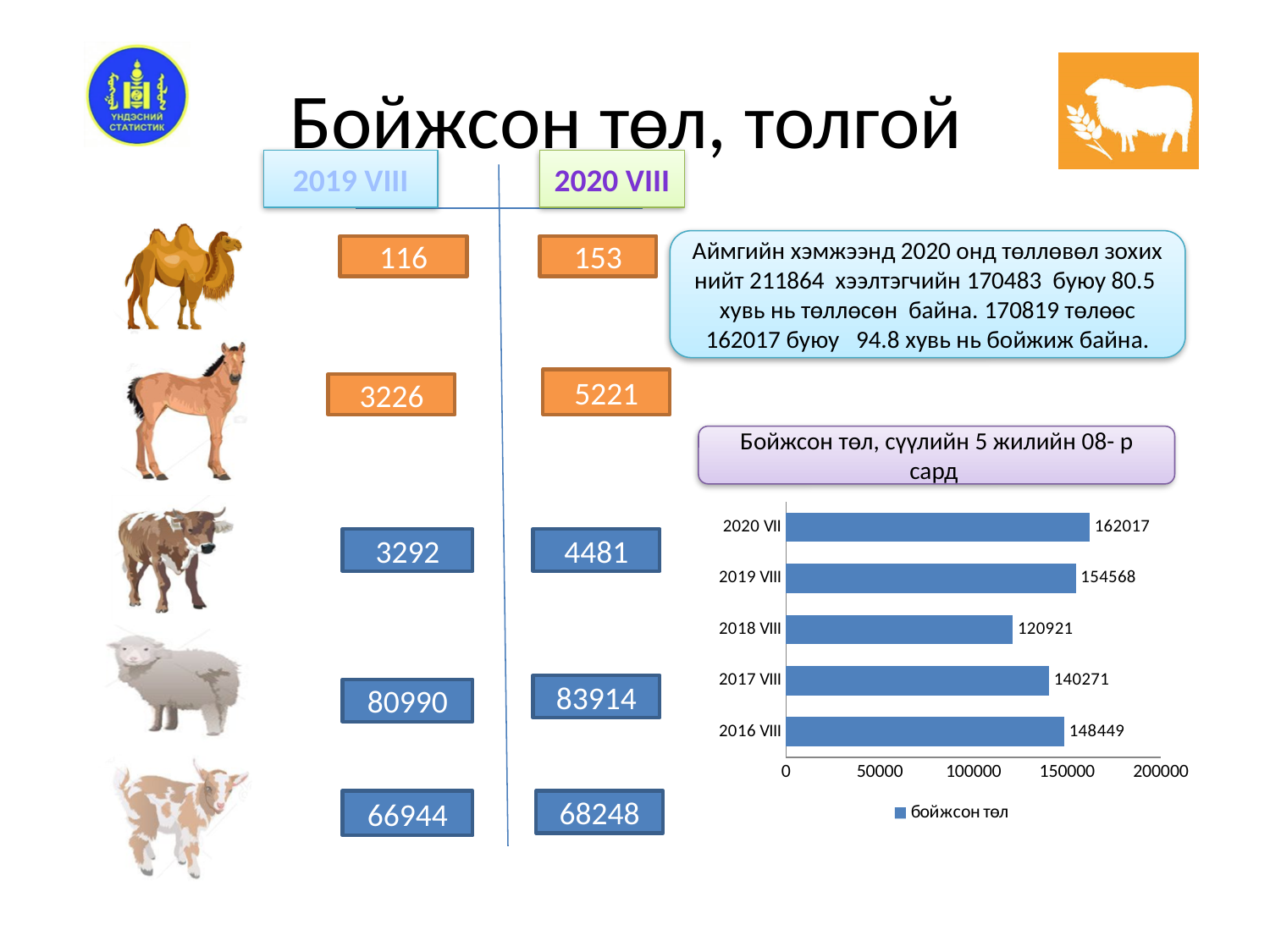
Is the value for 2018 VIII greater or less than 150000? less What is the difference between the values for 2020 VII and 2019 VIII? 7449 What is the value for 2020 VII in the chart? 162017 What is the value for 2018 VIII in the chart? 120921 How many series does the chart legend list? 1 What is the difference between the values for 2016 VIII and 2017 VIII? 8178 Which category has the lowest value in the chart? 2018 VIII Which category has the highest value in the chart? 2020 VII What kind of chart is shown on the slide? bar chart What is the value for 2016 VIII in the chart? 148449 How many categories are shown in the chart? 5 Which is larger, the value for 2017 VIII or the value for 2019 VIII? 2019 VIII